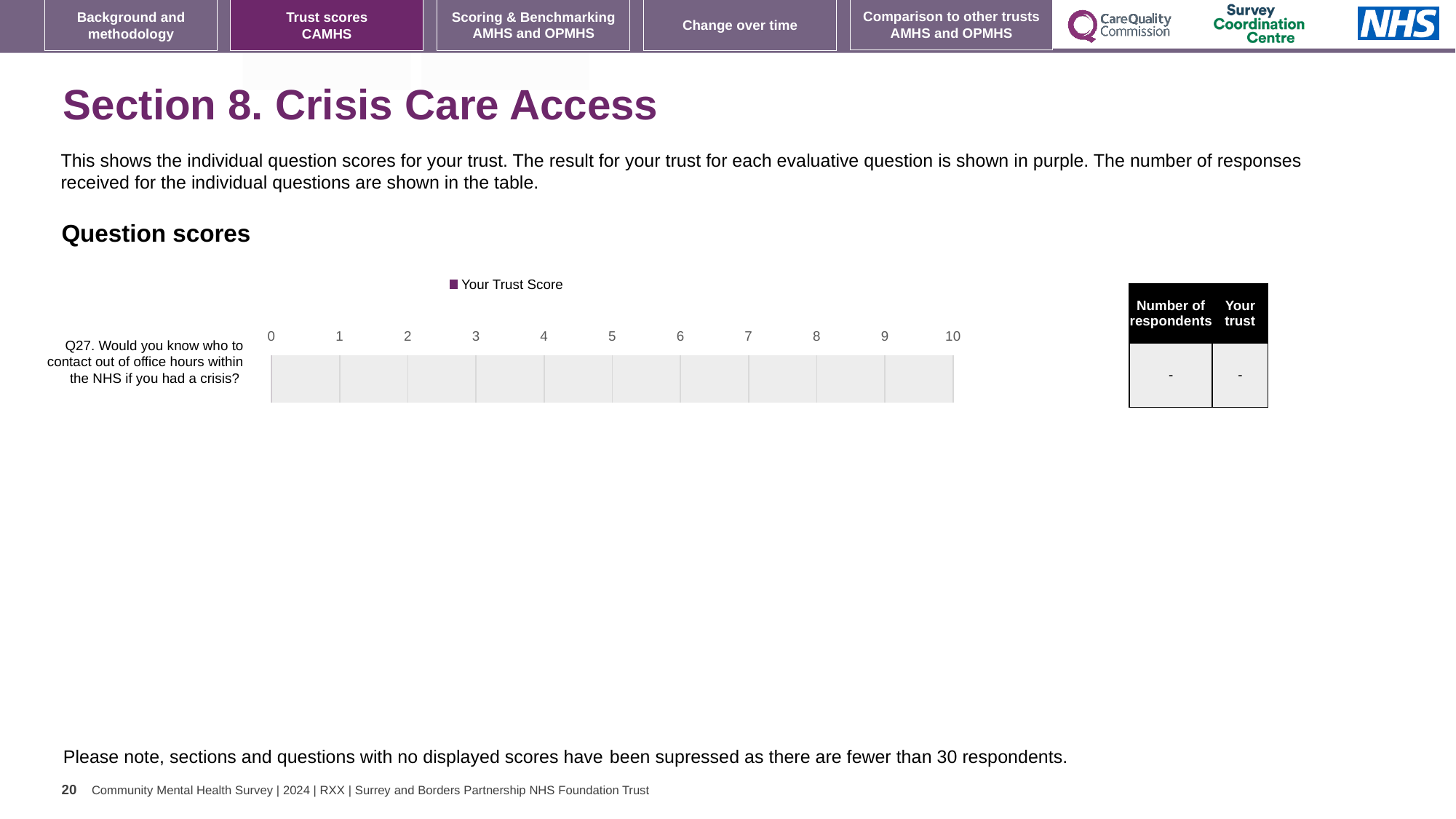
What is the name of the series shown in the chart legend? Your Trust Score What value is shown in the 'Your trust' column of the table for Q27? - What value is shown in the 'Number of respondents' column of the table for Q27? - How many series does the chart legend list? 1 What is the highest value shown on the chart's horizontal axis? 10 Which question is plotted on the chart? Q27. Would you know who to contact out of office hours within the NHS if you had a crisis? Is a score bar displayed for Q27 on the chart? No How many questions (categories) are listed on the chart's vertical axis? 1 What kind of chart is shown under the 'Question scores' heading? Bar chart